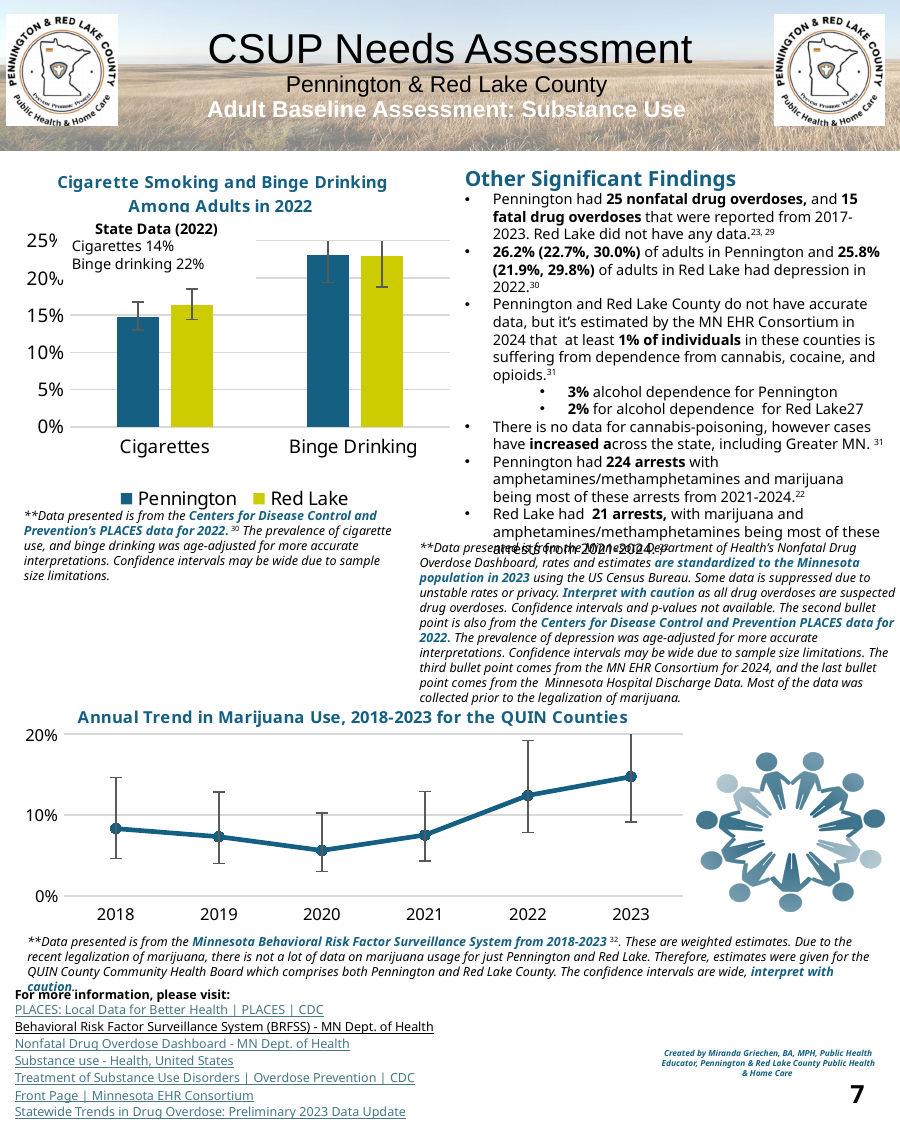
In the 'Annual Trend in Marijuana Use, 2018-2023 for the QUIN Counties' chart, which year has the highest value? 2023 In the 'Cigarette Smoking and Binge Drinking Among Adults in 2022' chart, which two series are listed in the legend? Pennington and Red Lake In the 'Annual Trend in Marijuana Use, 2018-2023 for the QUIN Counties' chart, which year has the lowest value? 2020 What kind of chart is the 'Annual Trend in Marijuana Use, 2018-2023 for the QUIN Counties' chart? line chart How many series does the legend of the 'Cigarette Smoking and Binge Drinking Among Adults in 2022' chart list? 2 What kind of chart is the 'Cigarette Smoking and Binge Drinking Among Adults in 2022' chart? bar chart In the 'Cigarette Smoking and Binge Drinking Among Adults in 2022' chart, is the Pennington value for Cigarettes greater or less than 20%? less In the 'Cigarette Smoking and Binge Drinking Among Adults in 2022' chart, is the Pennington value for Binge Drinking greater or less than 20%? greater How many categories are shown on the x axis of the 'Cigarette Smoking and Binge Drinking Among Adults in 2022' chart? 2 How many years are plotted in the 'Annual Trend in Marijuana Use, 2018-2023 for the QUIN Counties' chart? 6 In the 'Cigarette Smoking and Binge Drinking Among Adults in 2022' chart, which category has the higher values, Cigarettes or Binge Drinking? Binge Drinking In the 'Annual Trend in Marijuana Use, 2018-2023 for the QUIN Counties' chart, is the value for 2022 greater or less than 10%? greater